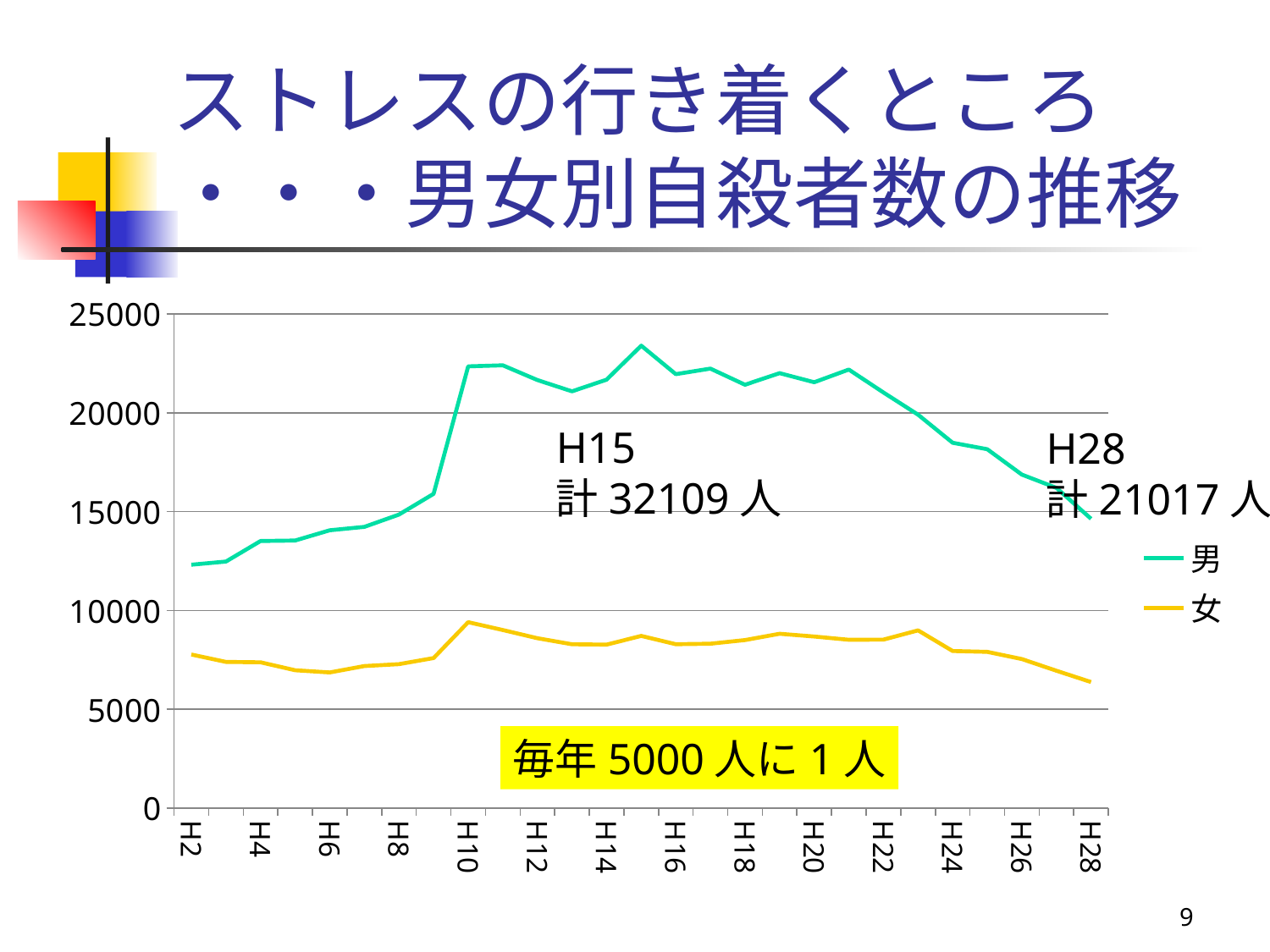
What kind of chart is shown on the slide? line chart Is the value for 女 at H2 greater or less than 10000? less According to the annotation on the chart, what is the total (計) for H28? 21017 人 How many series does the legend list? 2 Is the value for 男 at H2 greater or less than 10000? greater Is the value for 男 at H15 greater or less than 20000? greater What are the two series named in the legend? 男 and 女 Does the 男 series rise or fall from H22 to H28? fall According to the annotation on the chart, what is the total (計) for H15? 32109 人 In which year does the 男 series reach its highest value? H15 At H20, which series has the larger value, 男 or 女? 男